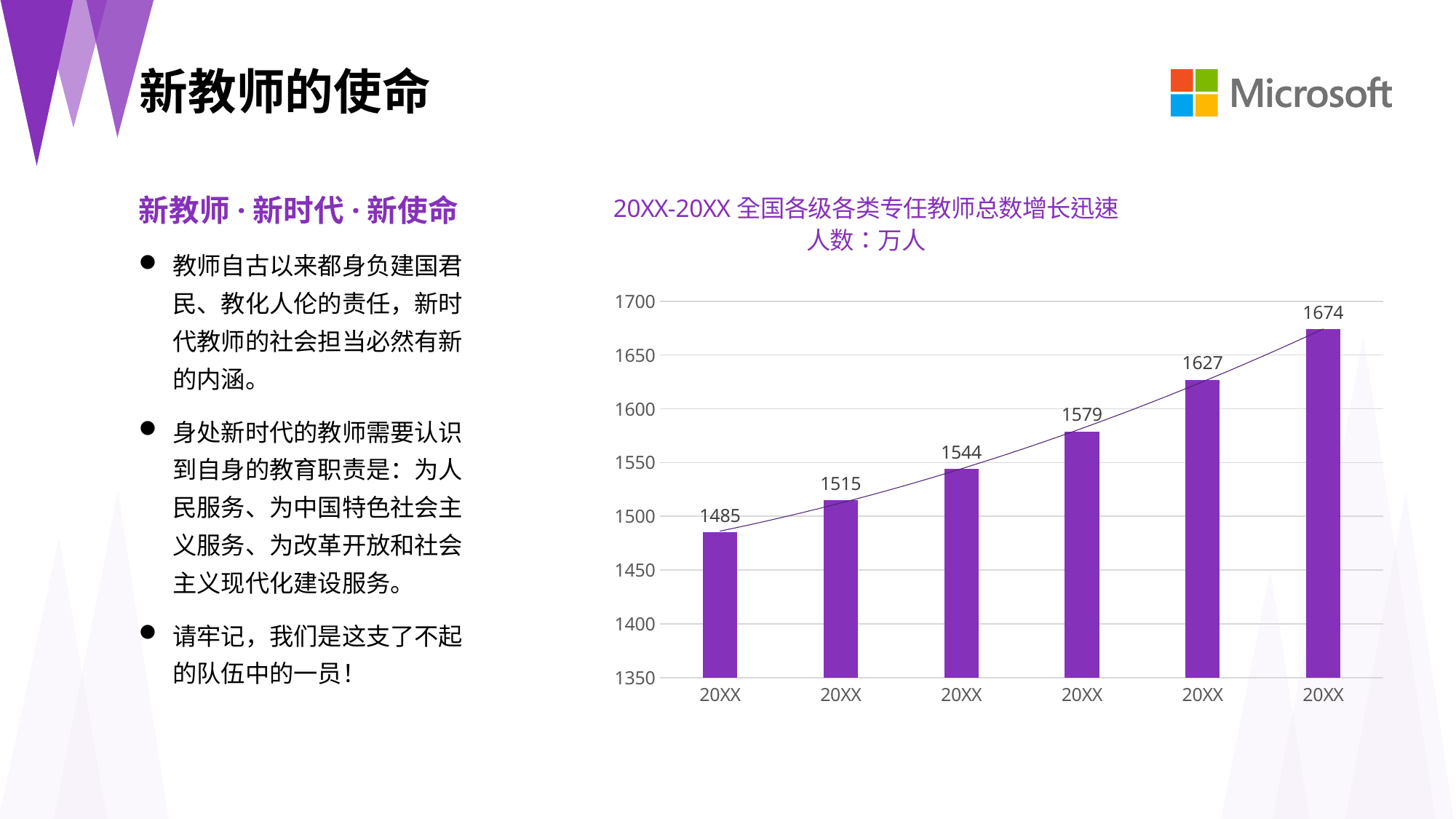
What is the value of the third bar from the left? 1544 What is the value of the leftmost (first) bar in the chart? 1485 What is the difference between the last bar (1674) and the first bar (1485)? 189 What is the lowest value shown in the chart? 1485 What is the value of the fifth bar from the left? 1627 What is the highest value shown in the chart? 1674 Which is larger, the second bar or the fourth bar? the fourth bar What kind of chart is shown on the slide? bar chart What is the value of the rightmost (last) bar in the chart? 1674 How many bars are plotted in the chart? 6 What is the difference between the fourth bar (1579) and the third bar (1544)? 35 Do the values rise or fall from left to right along the x axis? rise